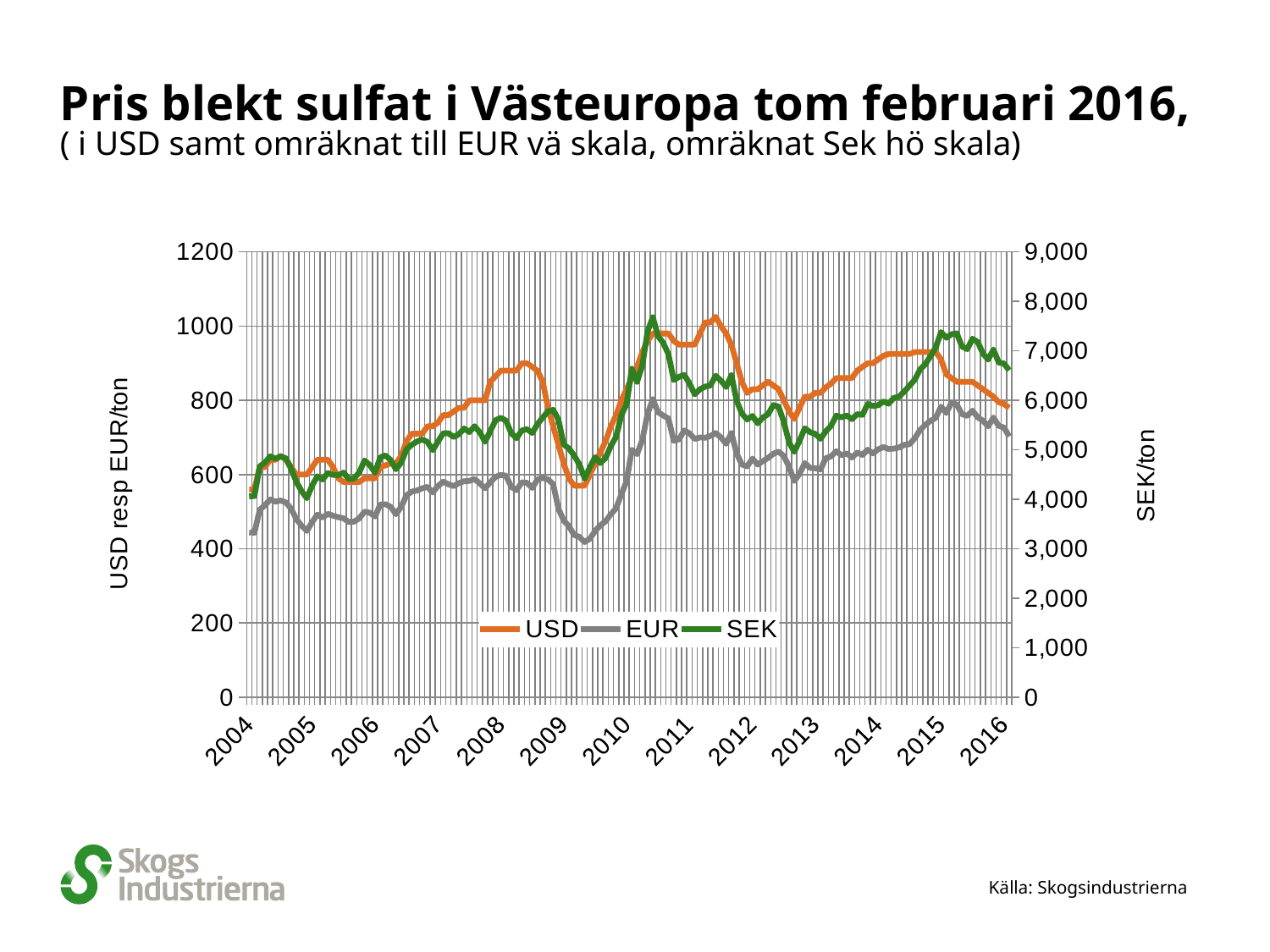
Is the value of the USD series at the end of the chart in 2016 greater or less than 1000? less Is the value of the SEK series at its 2010 peak greater or less than 7,000 on the right axis? greater How many series does the legend list? 3 Is the value of the SEK series at its lowest point in 2009 greater or less than 6,000 on the right axis? less Which series are listed in the legend? USD, EUR, SEK In 2011, which series is higher on the left axis, USD or EUR? USD Which of the two left-axis series, USD or EUR, reaches the highest value over the whole period? USD What kind of chart is shown on the slide? line chart What is the title of the left vertical axis? USD resp EUR/ton Does the USD series rise or fall between its low in 2009 and its peak in 2010? rise